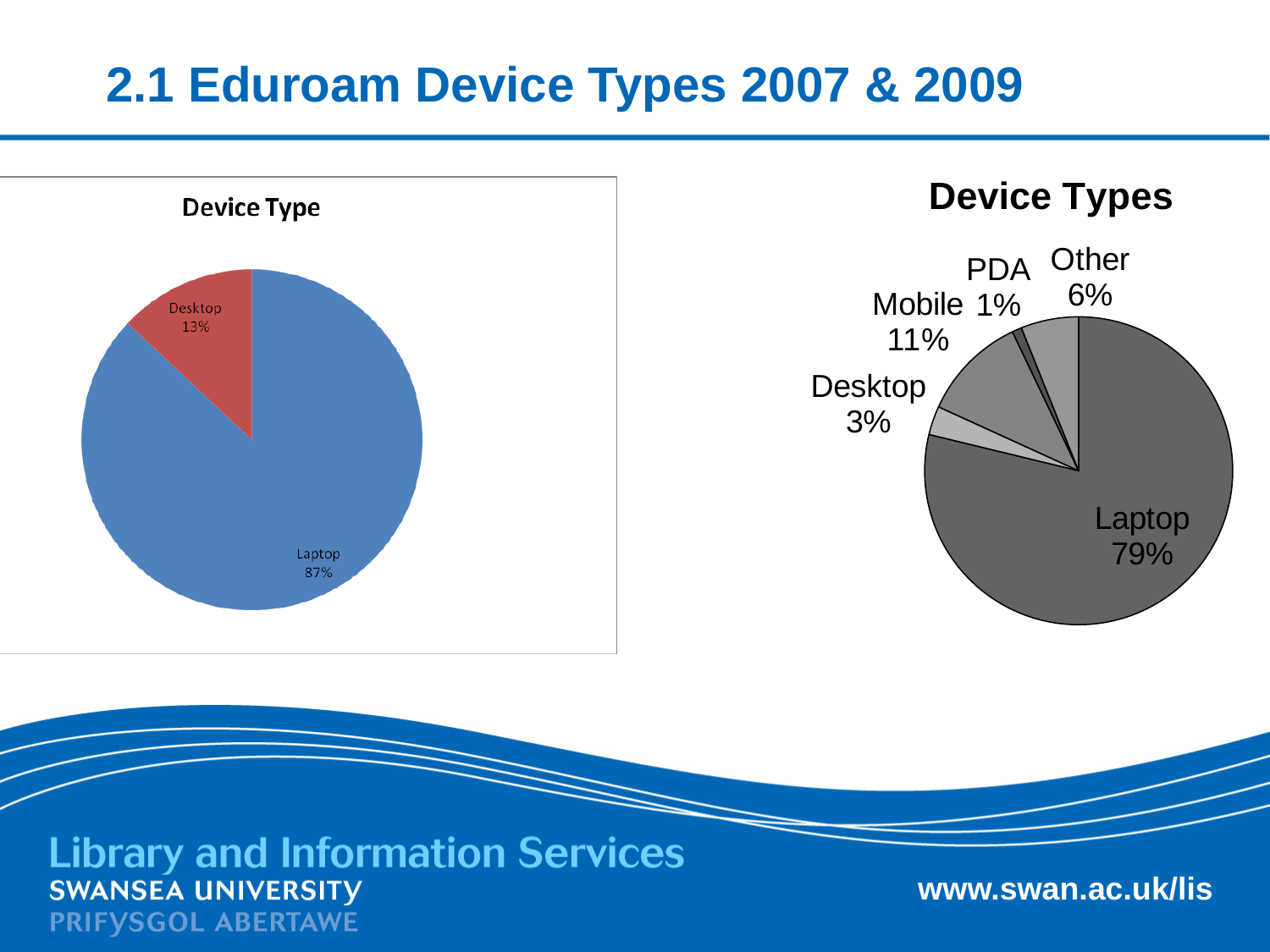
In the right pie chart titled "Device Types", what share is PDA? 1% In the right pie chart titled "Device Types", which category has the largest slice? Laptop In the right pie chart titled "Device Types", which category has the smallest slice? PDA In the left pie chart titled "Device Type", what share is Laptop? 87% In the right pie chart titled "Device Types", what is the difference between the Other and Desktop shares? 3% In the right pie chart titled "Device Types", what share is Laptop? 79% In the left pie chart titled "Device Type", how many categories are shown? 2 In the right pie chart titled "Device Types", what share is Mobile? 11% In the left pie chart titled "Device Type", what share is Desktop? 13% In the right pie chart titled "Device Types", which is larger, Mobile or Other? Mobile In the right pie chart titled "Device Types", how many categories are shown? 5 What kind of chart is the left chart titled "Device Type"? Pie chart